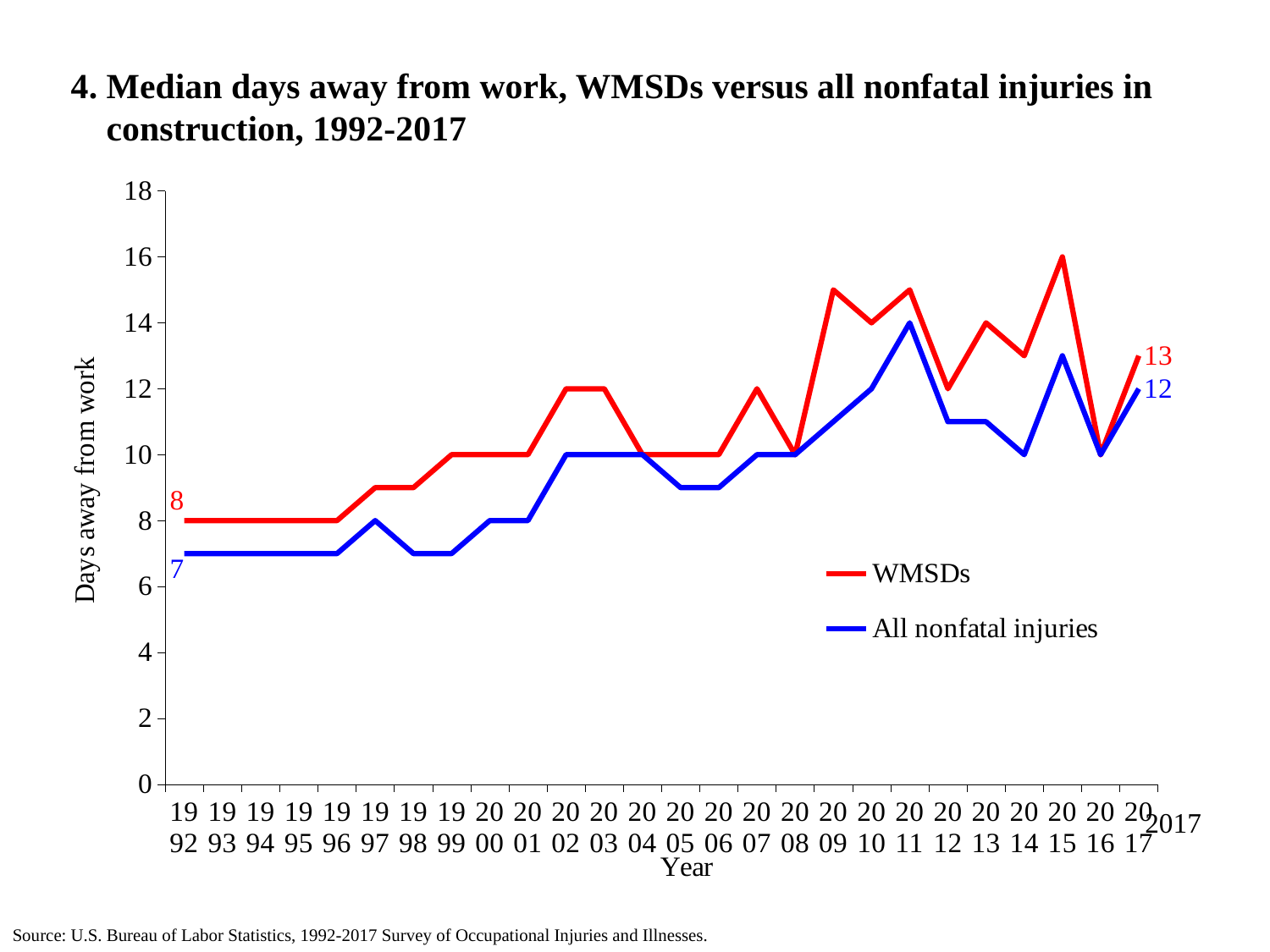
What is the median days away from work for all nonfatal injuries in 2017? 12 What type of chart is shown on the slide? line chart In which year does the WMSDs line reach its highest value? 2015 How many series does the legend list? 2 Overall, do the values for WMSDs rise or fall from 1992 to 2017? rise Which series has the higher value in 2009, WMSDs or all nonfatal injuries? WMSDs What is the WMSDs value in 2015? 16 Is the value for all nonfatal injuries in 2011 greater or less than 12? greater What is the median days away from work for WMSDs in 1992? 8 What is the median days away from work for WMSDs in 2017? 13 What is the difference between the WMSDs value and the all nonfatal injuries value in 2017? 1 What is the median days away from work for all nonfatal injuries in 1992? 7